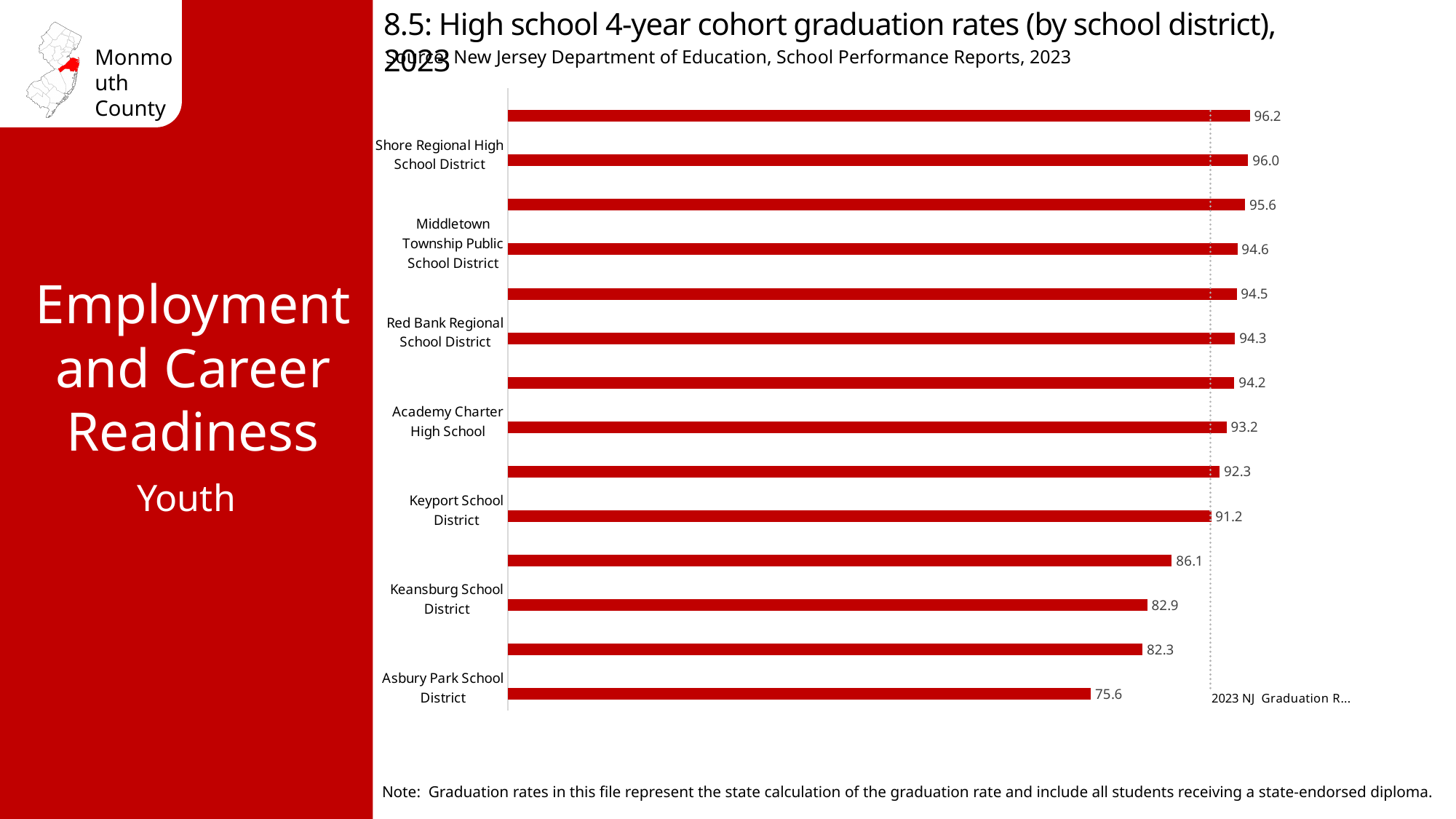
What is the difference between the graduation rates of Red Bank Regional School District and Academy Charter High School? 1.1 What is the graduation rate for Shore Regional High School District? 96.0 What is the graduation rate for Asbury Park School District? 75.6 Which has a higher graduation rate, Keyport School District or Keansburg School District? Keyport School District What type of chart is shown on the slide? bar chart Which labeled school district has the lowest graduation rate? Asbury Park School District What is the graduation rate for Middletown Township Public School District? 94.6 What colour are the bars in the chart? red How many bars are plotted in the chart? 14 What is the graduation rate for Keansburg School District? 82.9 What is the difference between the graduation rates of Shore Regional High School District and Asbury Park School District? 20.4 What is the graduation rate for Keyport School District? 91.2